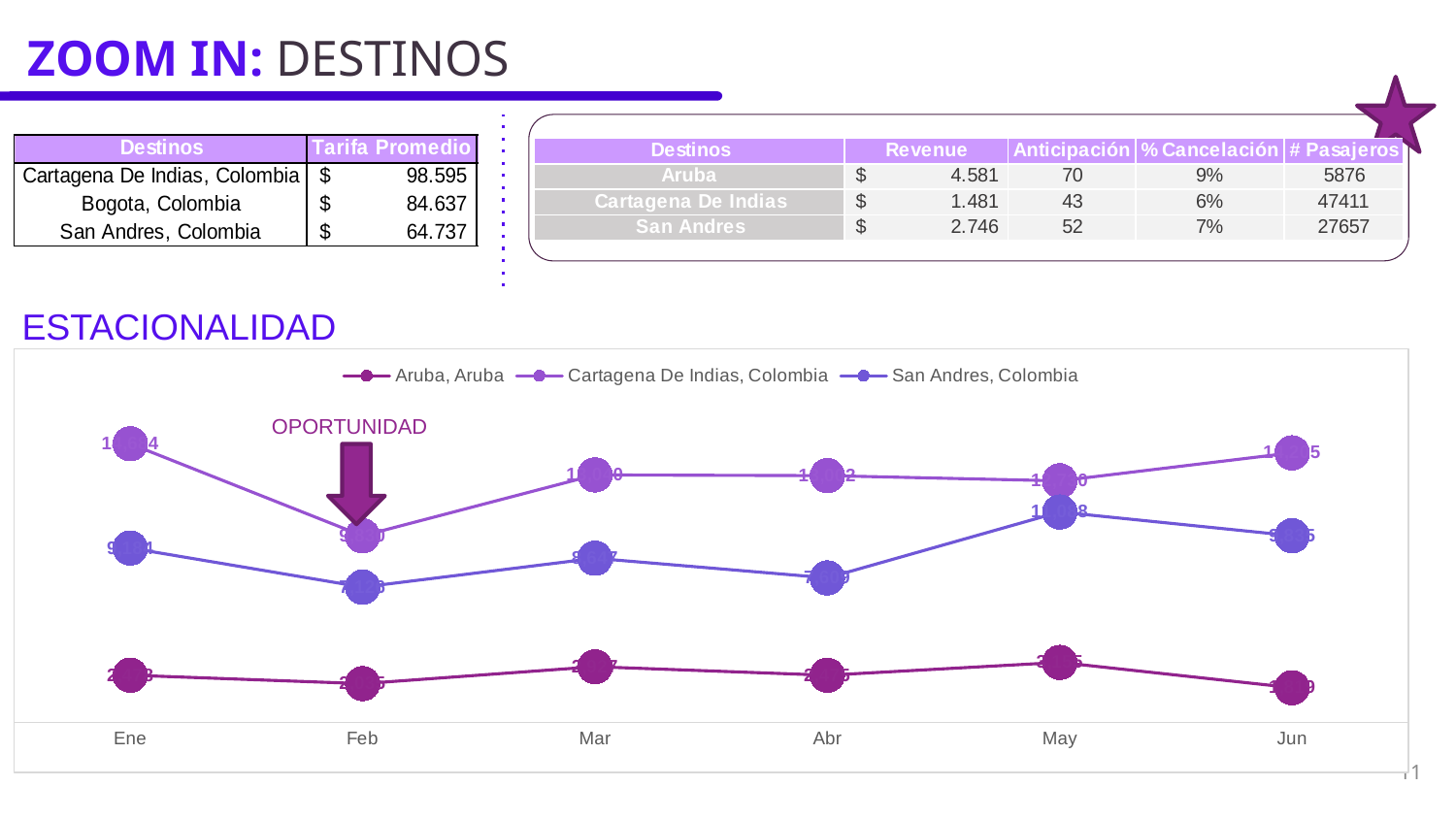
How many months are shown on the x axis of the ESTACIONALIDAD chart? 6 In the ESTACIONALIDAD chart, in which month is the value for Cartagena De Indias, Colombia lowest? Feb In the ESTACIONALIDAD chart, which month does the OPORTUNIDAD arrow point to? Feb In the ESTACIONALIDAD chart, in which month is the value for San Andres, Colombia lowest? Feb In the ESTACIONALIDAD chart, which is larger in Jun: Aruba, Aruba or San Andres, Colombia? San Andres, Colombia How many series does the legend of the ESTACIONALIDAD chart list? 3 In the ESTACIONALIDAD chart, which series has the lowest values across all months? Aruba, Aruba What kind of chart is shown under the heading ESTACIONALIDAD? Line chart In the ESTACIONALIDAD chart, in which month is the value for San Andres, Colombia highest? May In the ESTACIONALIDAD chart, does the value for San Andres, Colombia rise or fall from Abr to May? Rise In the ESTACIONALIDAD chart, which is larger in Ene: Cartagena De Indias, Colombia or San Andres, Colombia? Cartagena De Indias, Colombia In the ESTACIONALIDAD chart, does the value for Cartagena De Indias, Colombia rise or fall from Ene to Feb? Fall